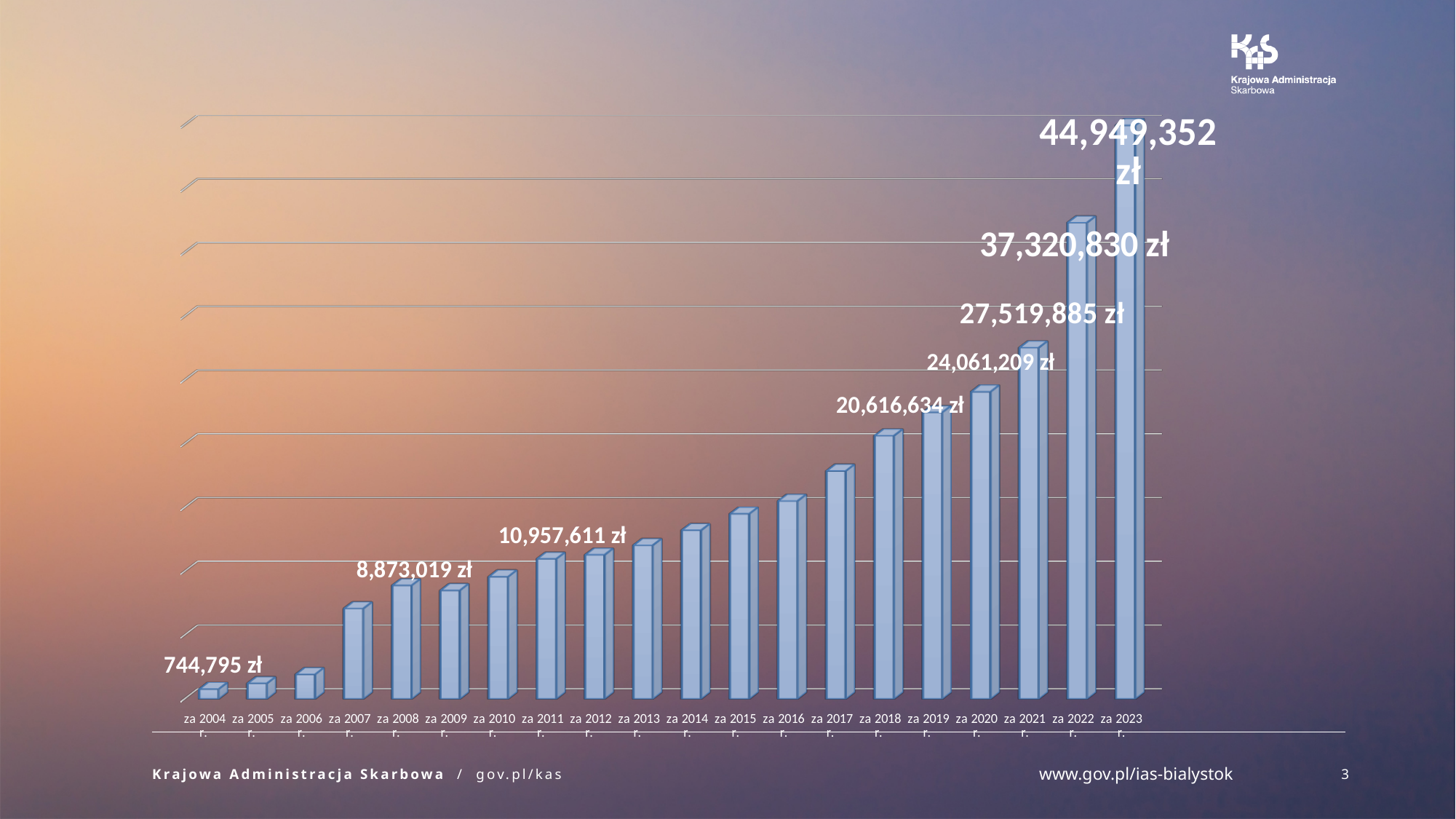
What is the value shown for 'za 2004 r.'? 744,795 zł Which year has the highest value in the chart? za 2023 r. What is the value shown for 'za 2021 r.'? 27,519,885 zł What is the value shown for 'za 2011 r.'? 10,957,611 zł What is the value shown for 'za 2022 r.'? 37,320,830 zł Which year has the lowest value in the chart? za 2004 r. What kind of chart is shown on the slide? bar chart What is the value shown for 'za 2023 r.'? 44,949,352 zł How many years (categories) are shown on the x axis of the chart? 20 What is the difference between the values for 'za 2023 r.' and 'za 2022 r.'? 7,628,522 zł Do the values generally rise or fall from 2004 to 2023? rise Which is larger, the value for 'za 2022 r.' or for 'za 2021 r.'? za 2022 r.